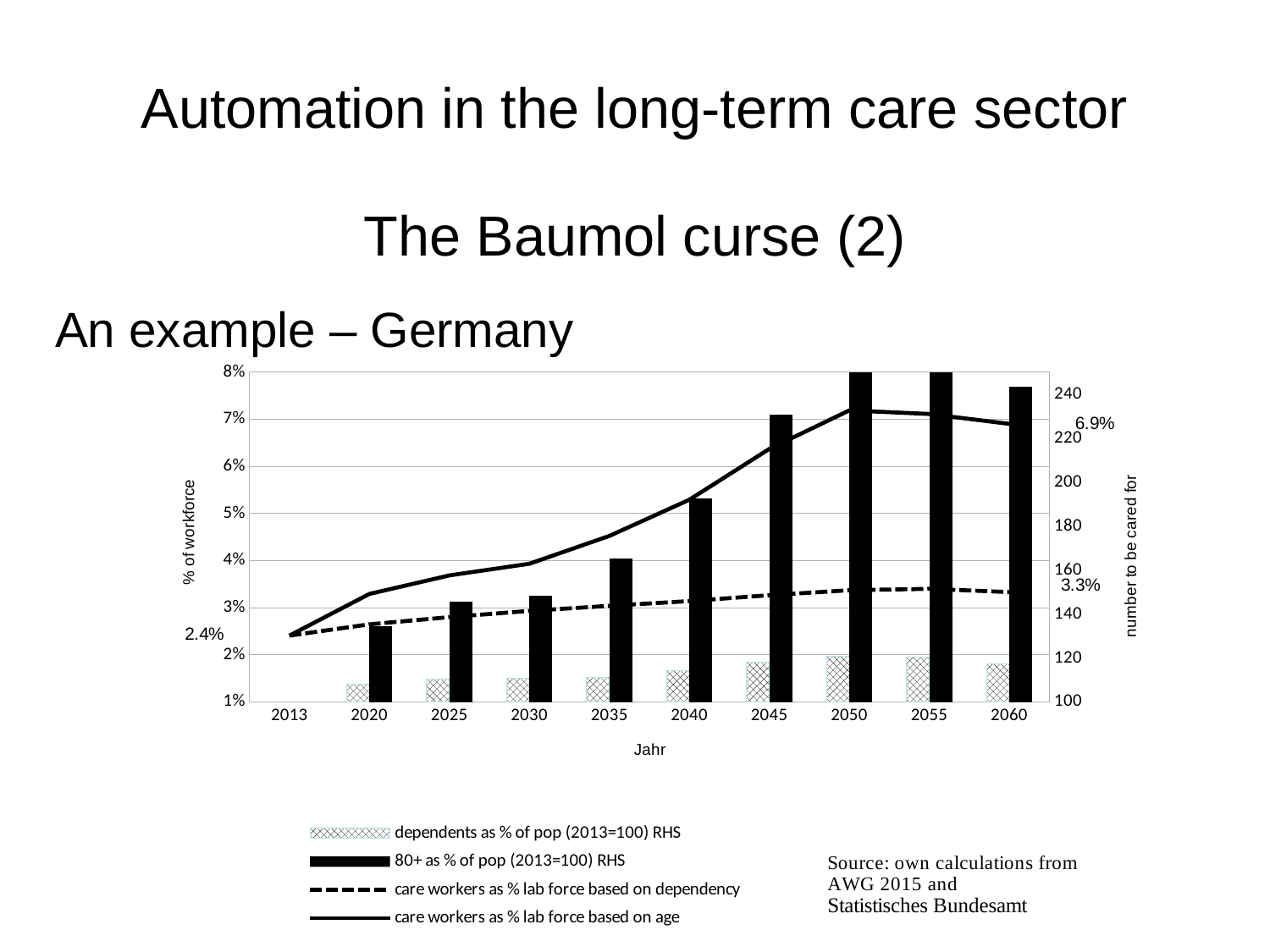
In 2060, which is larger: care workers as % lab force based on age or based on dependency? care workers as % lab force based on age Is the 'dependents as % of pop (2013=100) RHS' bar for 2050 greater or less than 140 on the right-hand axis? less What is the value of 'care workers as % lab force based on dependency' in 2060? 3.3% Among the years with bars, which year has the lowest '80+ as % of pop (2013=100) RHS' bar? 2020 In 2060, what is the difference between the care workers share based on age and the share based on dependency? 3.6% How many series does the chart legend list? 4 What is the value of 'care workers as % lab force based on age' in 2060? 6.9% Between 2013 and 2050, does the 'care workers as % lab force based on age' line rise or fall? rise Is the '80+ as % of pop (2013=100) RHS' bar for 2040 greater or less than 180 on the right-hand axis? greater What value do the care worker lines start at in 2013? 2.4% What is the title of the x axis of the chart? Jahr How many years are shown on the x axis of the chart? 10